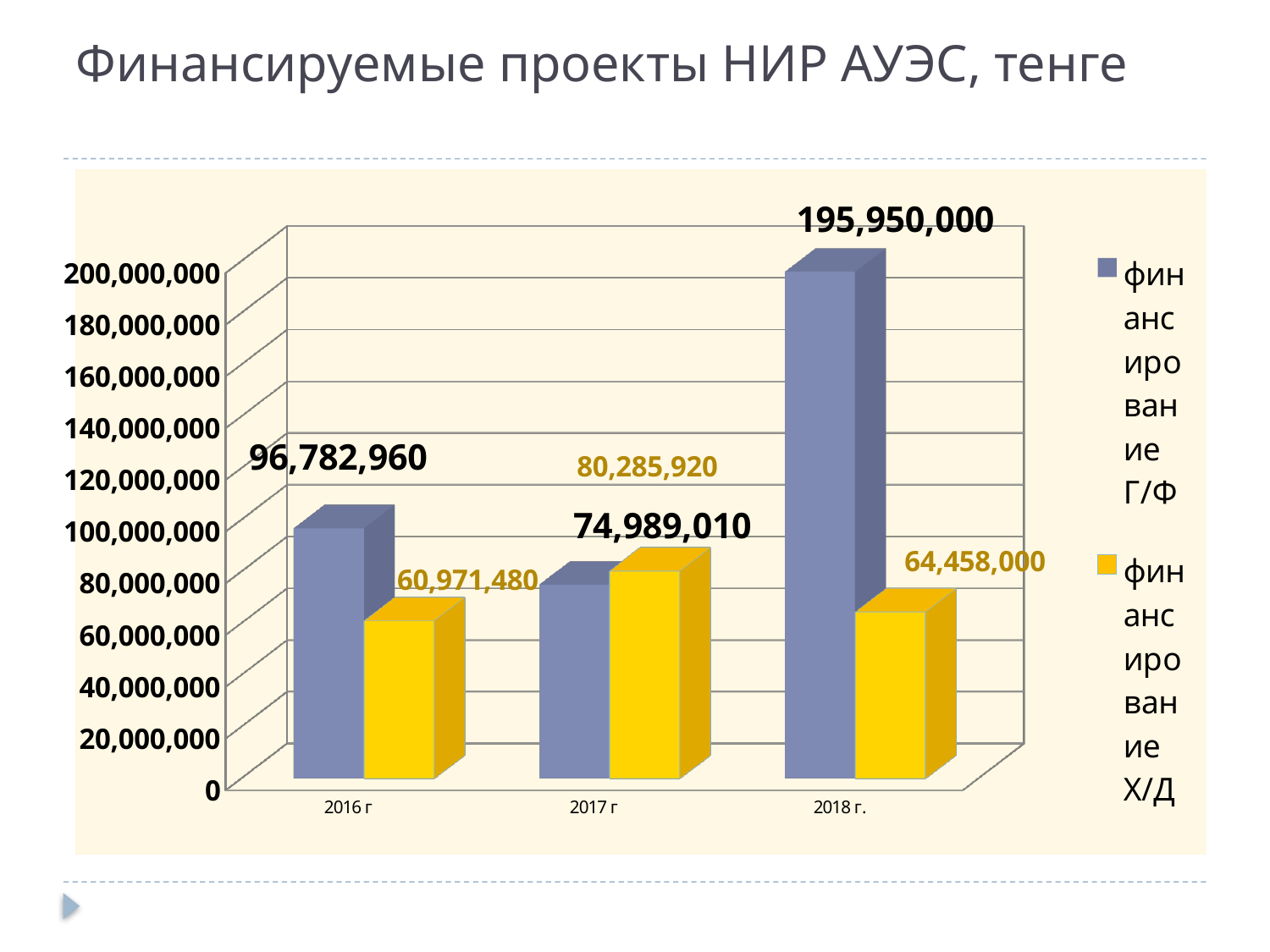
What is the difference between финансирование Г/Ф and финансирование Х/Д in 2016 г? 35,811,480 In 2017 г, which is larger: финансирование Г/Ф or финансирование Х/Д? финансирование Х/Д What kind of chart is shown on the slide? bar chart What is the value of финансирование Х/Д for 2016 г? 60,971,480 What is the value of финансирование Г/Ф for 2017 г? 74,989,010 How many series does the legend list? 2 What is the value of финансирование Х/Д for 2017 г? 80,285,920 Is the value of финансирование Х/Д for 2018 г. greater or less than 80,000,000? less What is the difference between финансирование Г/Ф in 2018 г. and in 2016 г? 99,167,040 In which year is финансирование Х/Д lowest? 2016 г In which year is финансирование Г/Ф highest? 2018 г. What is the value of финансирование Г/Ф for 2018 г.? 195,950,000